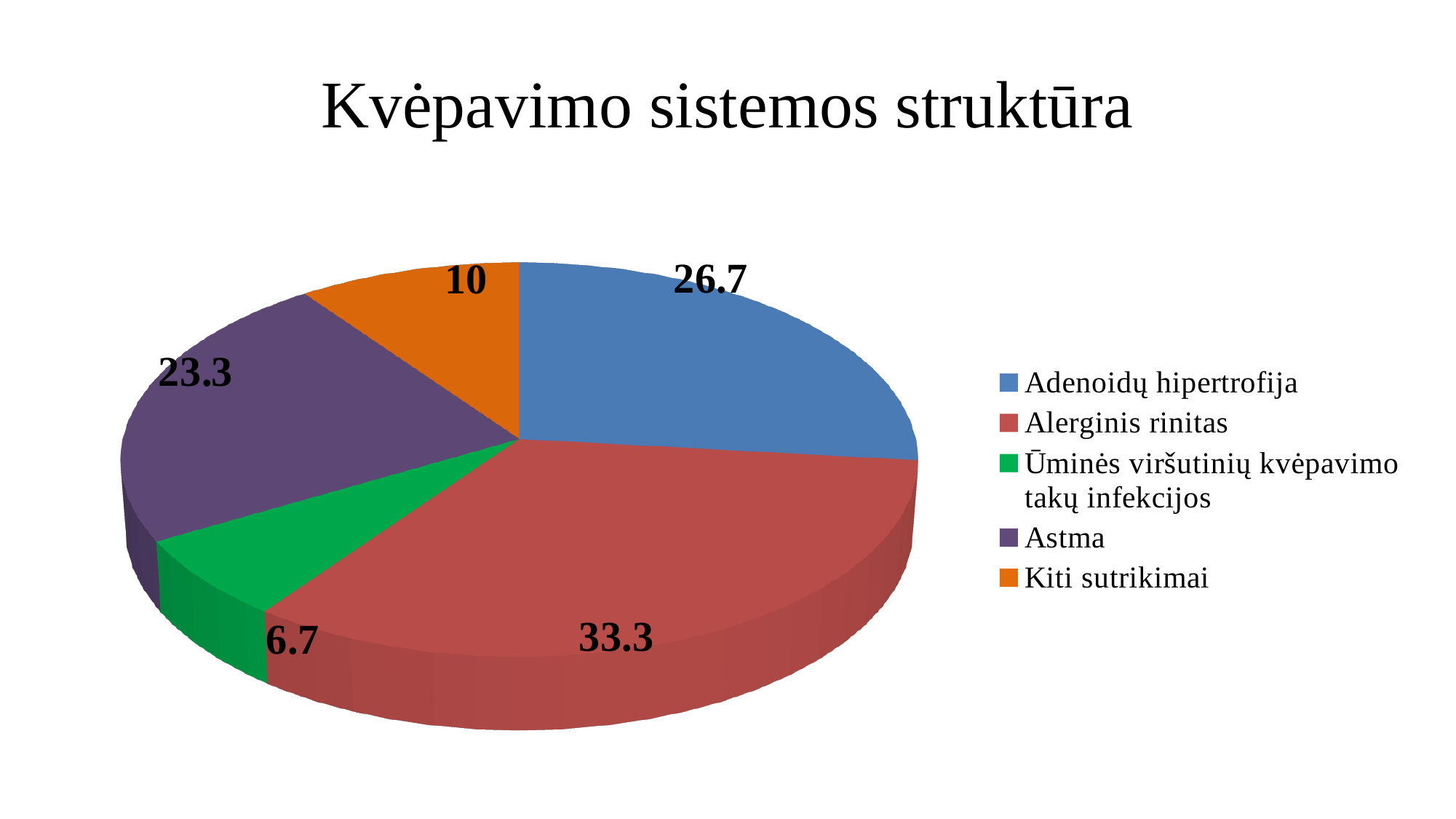
What kind of chart is shown on the slide? Pie chart Which category has the smallest slice? Ūminės viršutinių kvėpavimo takų infekcijos What is the difference between the values for Alerginis rinitas and Adenoidų hipertrofija? 6.6 What is the value for Ūminės viršutinių kvėpavimo takų infekcijos? 6.7 What is the value for Adenoidų hipertrofija? 26.7 Which is larger, the value for Astma or the value for Kiti sutrikimai? Astma What is the title of the chart? Kvėpavimo sistemos struktūra What is the value for Astma? 23.3 How many categories does the pie chart show? 5 What is the value for Alerginis rinitas? 33.3 Which category has the largest slice? Alerginis rinitas What is the value for Kiti sutrikimai? 10